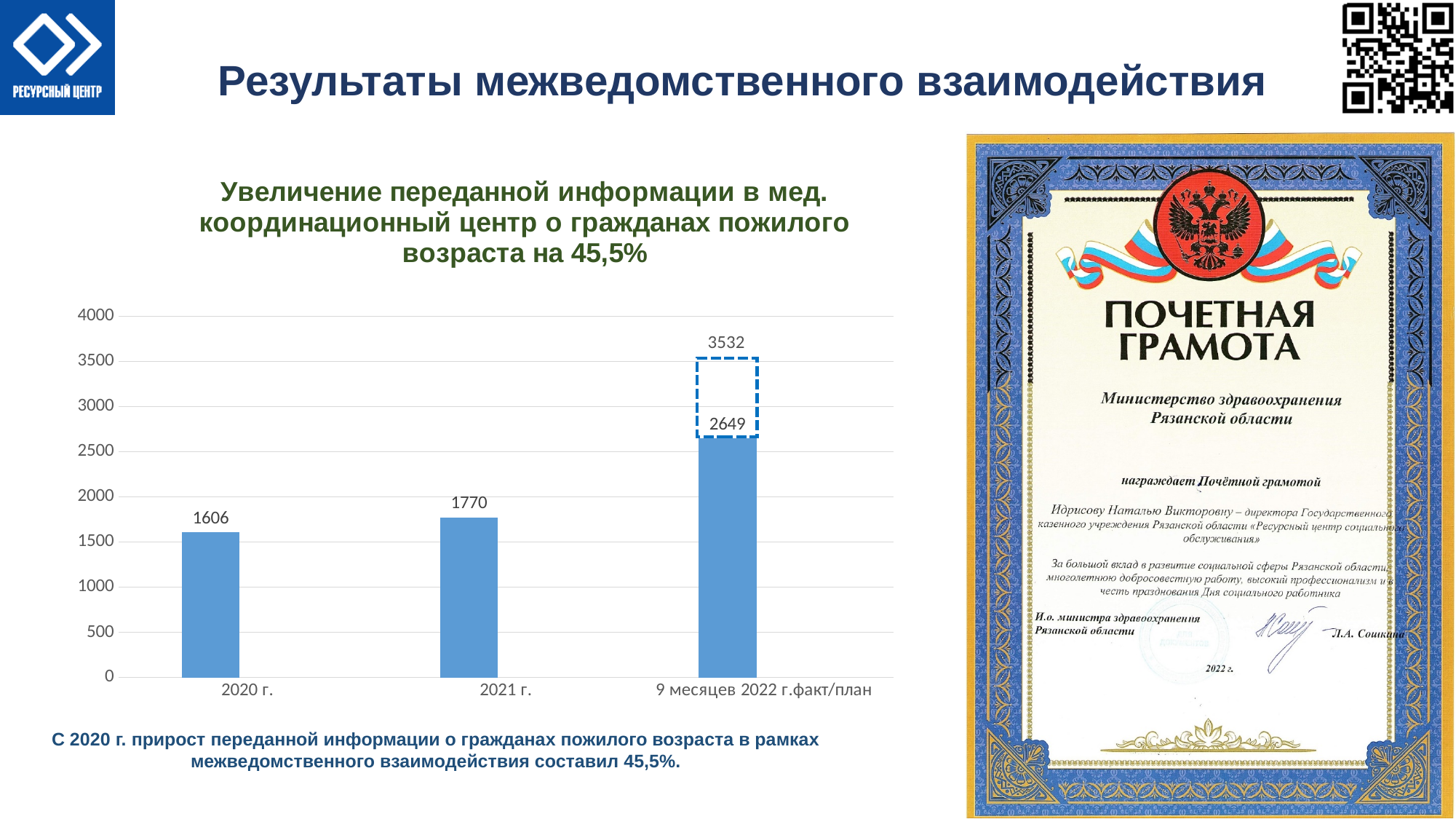
What is the difference between the values for 2021 г. and 2020 г.? 164 What is the value for 2021 г.? 1770 How many categories are shown on the x axis? 3 What is the difference between the planned and actual values for 9 месяцев 2022 г.? 883 Which category has the highest solid bar? 9 месяцев 2022 г.факт/план What kind of chart is shown on the slide? Bar chart What is the value for 2020 г.? 1606 What is the actual (факт) value shown for 9 месяцев 2022 г.? 2649 Which category has the lowest value? 2020 г. Which is larger, the value for 2021 г. or the value for 2020 г.? 2021 г. What is the planned (план) value shown for 9 месяцев 2022 г.? 3532 Do the values rise or fall from 2020 г. to 9 месяцев 2022 г.? Rise